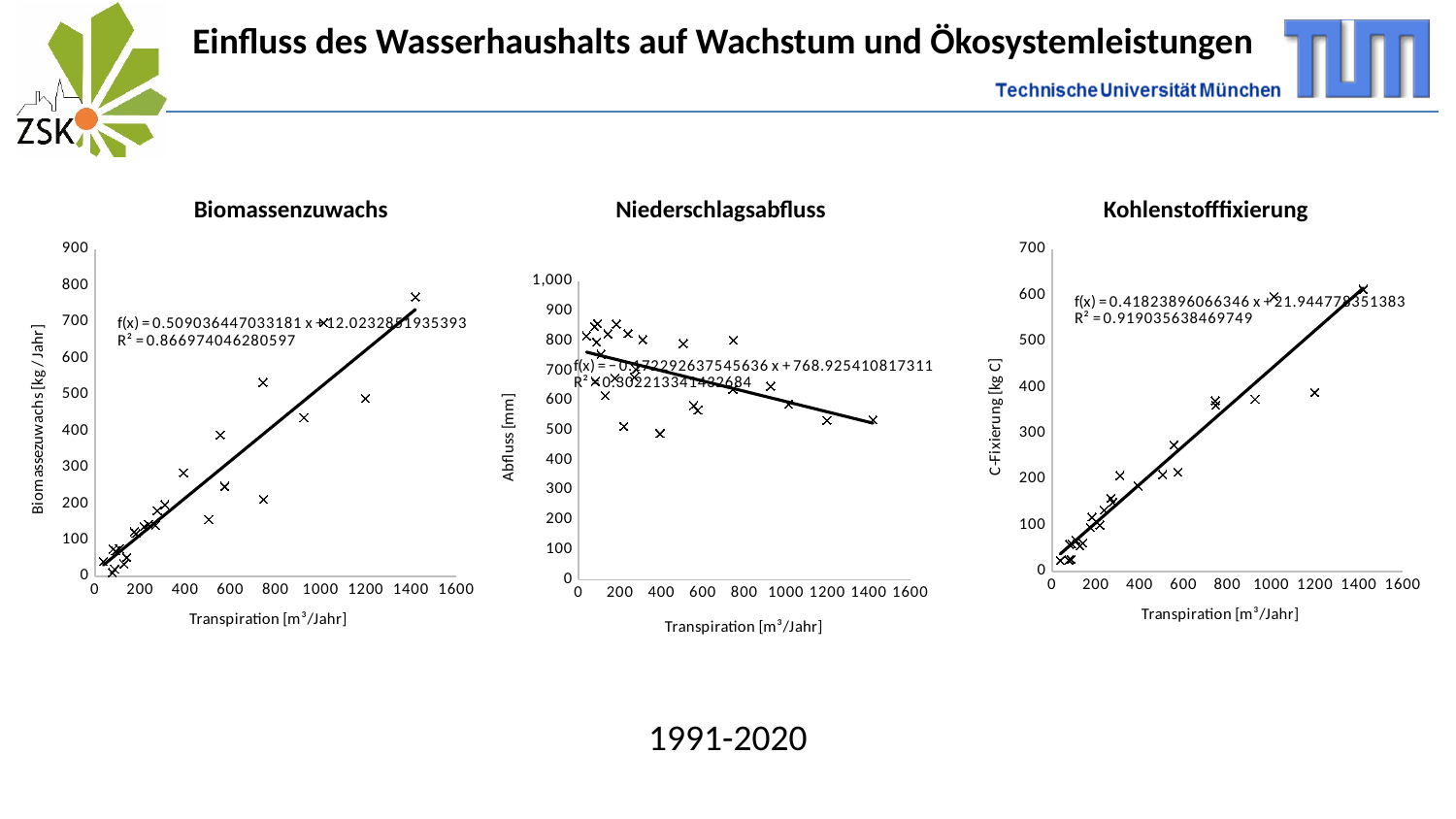
In the Biomassenzuwachs chart, do the plotted values rise or fall as transpiration increases along the x axis? rise How many charts are shown on the slide? 3 What is the y-axis label of the Niederschlagsabfluss chart? Abfluss [mm] In the Niederschlagsabfluss chart, do the plotted values rise or fall as transpiration increases along the x axis? fall In the Biomassenzuwachs chart, is the highest plotted point greater or less than 700? greater In the Kohlenstofffixierung chart, do the plotted values rise or fall as transpiration increases along the x axis? rise What kind of chart is the Biomassenzuwachs chart? scatter chart In the Kohlenstofffixierung chart, is the highest plotted point greater or less than 500? greater What R² value is printed on the Kohlenstofffixierung chart? 0.919035638469749 In the Niederschlagsabfluss chart, is the lowest plotted point greater or less than 600? less What is the x-axis label of the Kohlenstofffixierung chart? Transpiration [m³/Jahr] What R² value is printed on the Biomassenzuwachs chart? 0.866974046280597